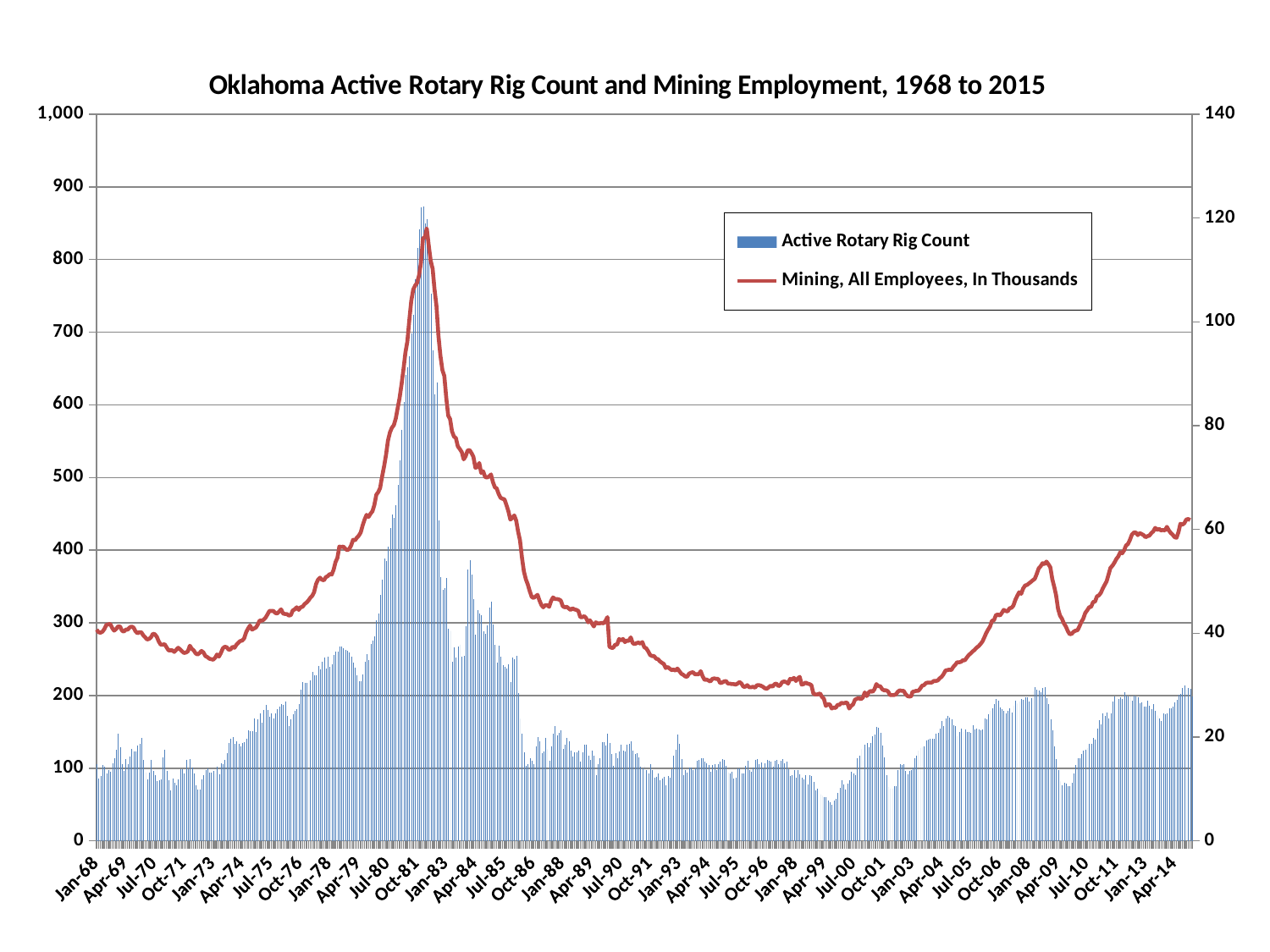
Is the value of Mining, All Employees, In Thousands at Apr-14 greater or less than 40? greater What kind of chart is shown on the slide? A combined bar and line chart Which is larger: Mining, All Employees, In Thousands at Apr-14 or at Jan-68? Apr-14 Around which x-axis label does the Active Rotary Rig Count reach its highest value? Oct-81 Which series is drawn as a red line? Mining, All Employees, In Thousands How many series does the legend list? 2 Is the peak value of Mining, All Employees, In Thousands greater or less than 100? greater Does Mining, All Employees, In Thousands rise or fall between Oct-81 and Oct-86? fall What is the title of the chart? Oklahoma Active Rotary Rig Count and Mining Employment, 1968 to 2015 Is the Active Rotary Rig Count around Jul-99 greater or less than 100? less